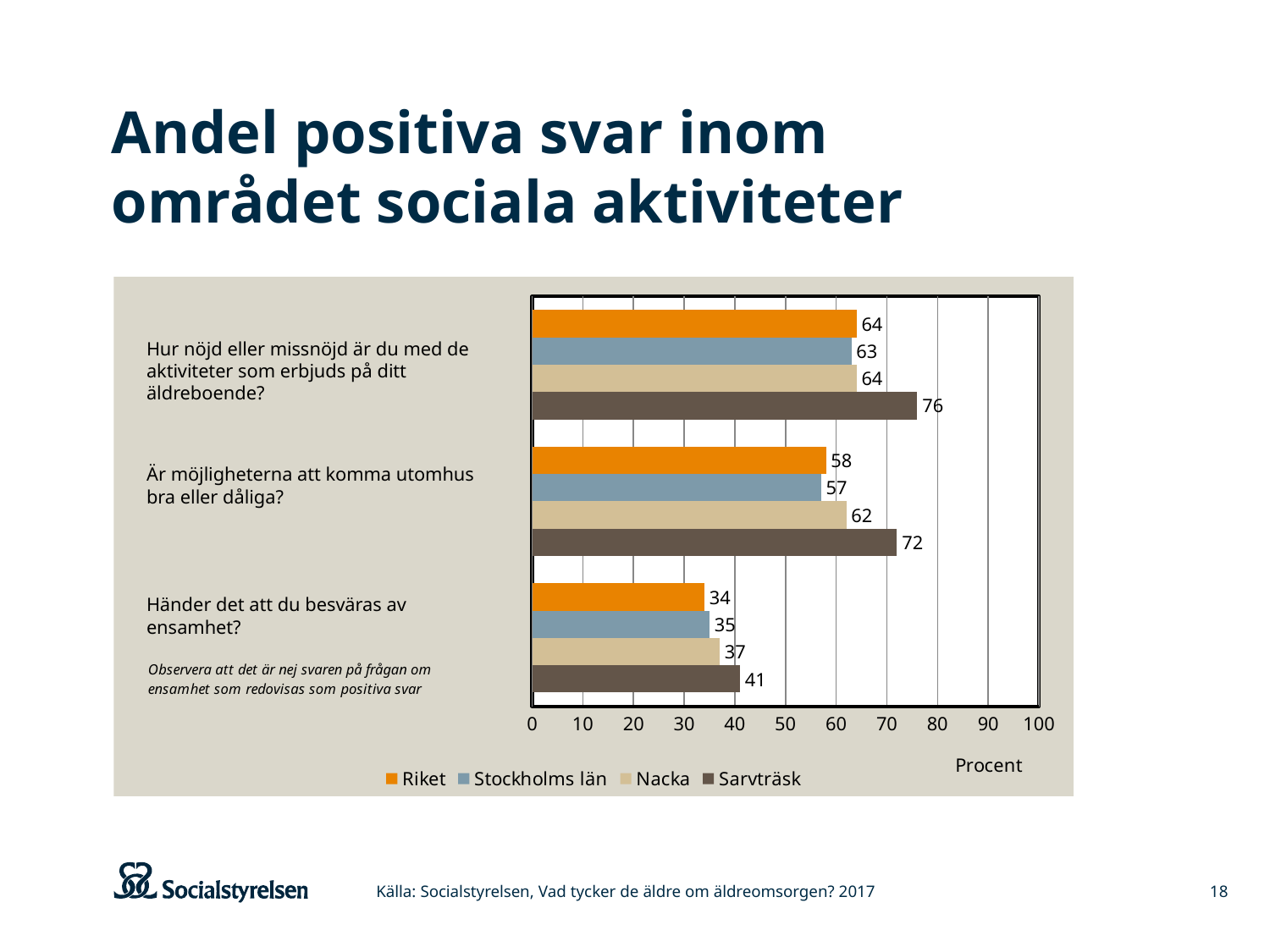
Which series has the lowest value on the question "Händer det att du besväras av ensamhet?"? Riket Which series has the highest value on the question "Är möjligheterna att komma utomhus bra eller dåliga?"? Sarvträsk What is the value for Stockholms län on the question "Är möjligheterna att komma utomhus bra eller dåliga?"? 57 What is the value for Sarvträsk on the question "Hur nöjd eller missnöjd är du med de aktiviteter som erbjuds på ditt äldreboende?"? 76 What unit is shown on the horizontal axis of the chart? Procent What is the difference between the Sarvträsk and Nacka values on the question "Är möjligheterna att komma utomhus bra eller dåliga?"? 10 What is the difference between the Sarvträsk and Riket values on the question "Hur nöjd eller missnöjd är du med de aktiviteter som erbjuds på ditt äldreboende?"? 12 What is the value for Nacka on the question "Händer det att du besväras av ensamhet?"? 37 How many questions (categories) are shown on the chart? 3 How many series does the legend list? 4 What kind of chart is shown on the slide? Bar chart Which is larger: the Nacka value or the Stockholms län value on the question "Är möjligheterna att komma utomhus bra eller dåliga?"? Nacka